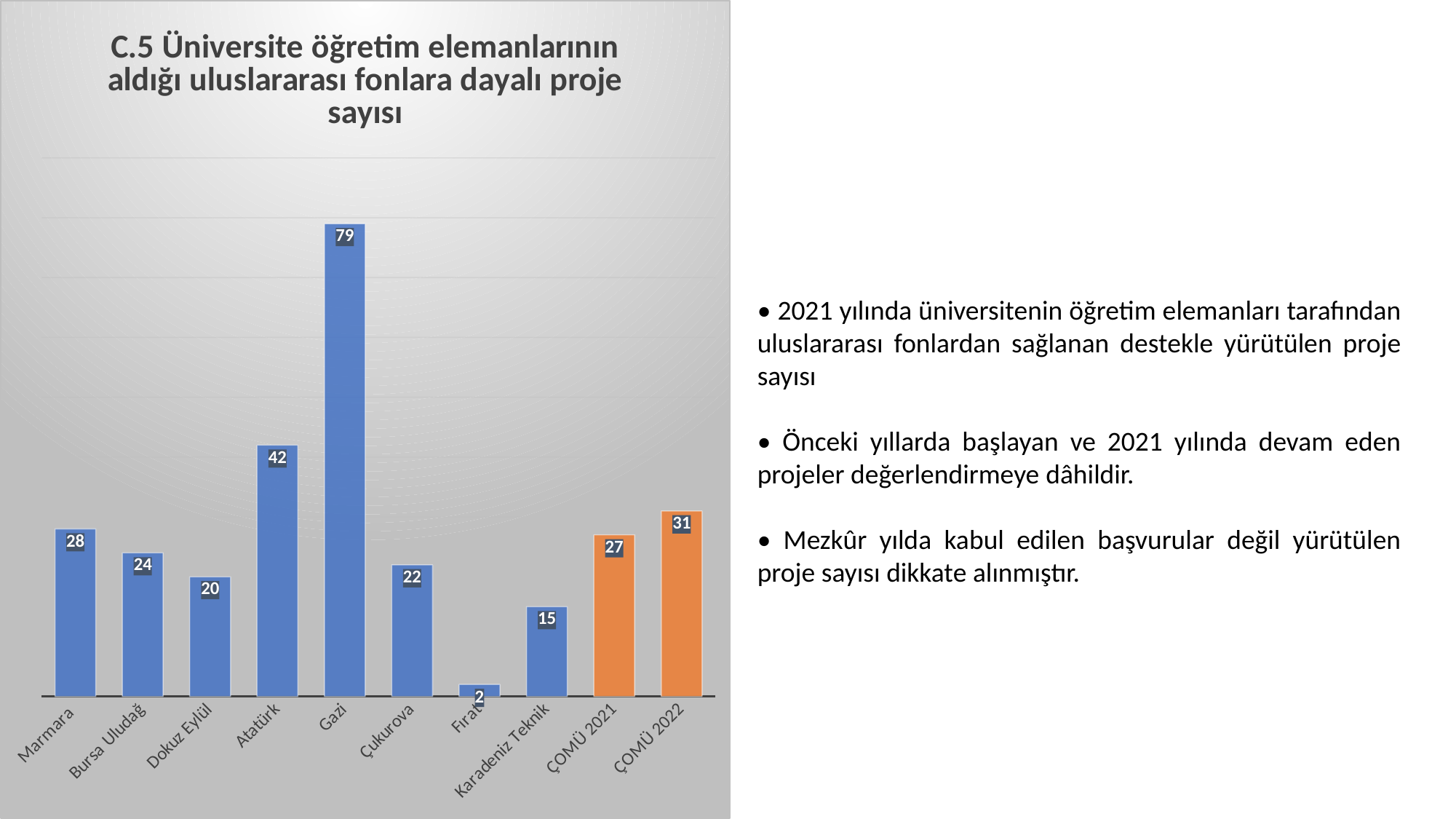
Which category has the lowest value? Fırat What kind of chart is this? Bar chart What is the difference between the values for Gazi and Atatürk? 37 How many categories are shown on the x axis? 10 Which category has the highest value? Gazi Which is larger, the value for Marmara or the value for Bursa Uludağ? Marmara What is the title of the chart? C.5 Üniversite öğretim elemanlarının aldığı uluslararası fonlara dayalı proje sayısı What is the value for ÇOMÜ 2022? 31 What is the difference between the values for ÇOMÜ 2022 and ÇOMÜ 2021? 4 Which categories are shown with orange bars? ÇOMÜ 2021 and ÇOMÜ 2022 What is the value for Karadeniz Teknik? 15 What is the value for Gazi? 79